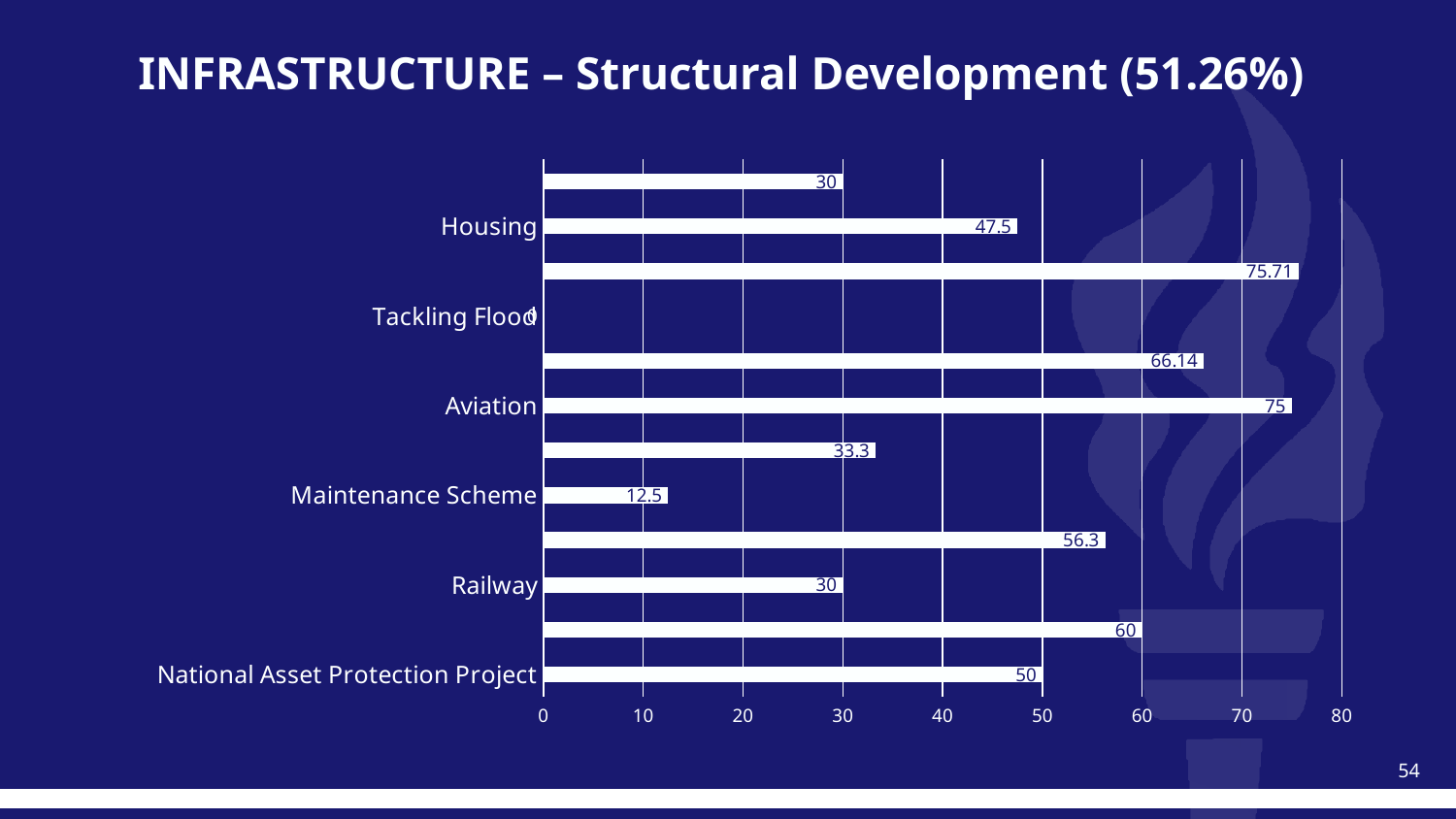
What is the value for Aviation? 75 What is the value for Maintenance Scheme? 12.5 What is the value for National Asset Protection Project? 50 What is the title of the slide? INFRASTRUCTURE – Structural Development (51.26%) What is the value for Railway? 30 What is the value for Tackling Flood? 0 Which labelled category has the lowest value? Tackling Flood What is the value for Housing? 47.5 What is the difference between the values for Aviation and Housing? 27.5 How many bars are plotted in the chart? 12 What type of chart is shown on the slide? Bar chart Which is larger, the value for Railway or the value for National Asset Protection Project? National Asset Protection Project